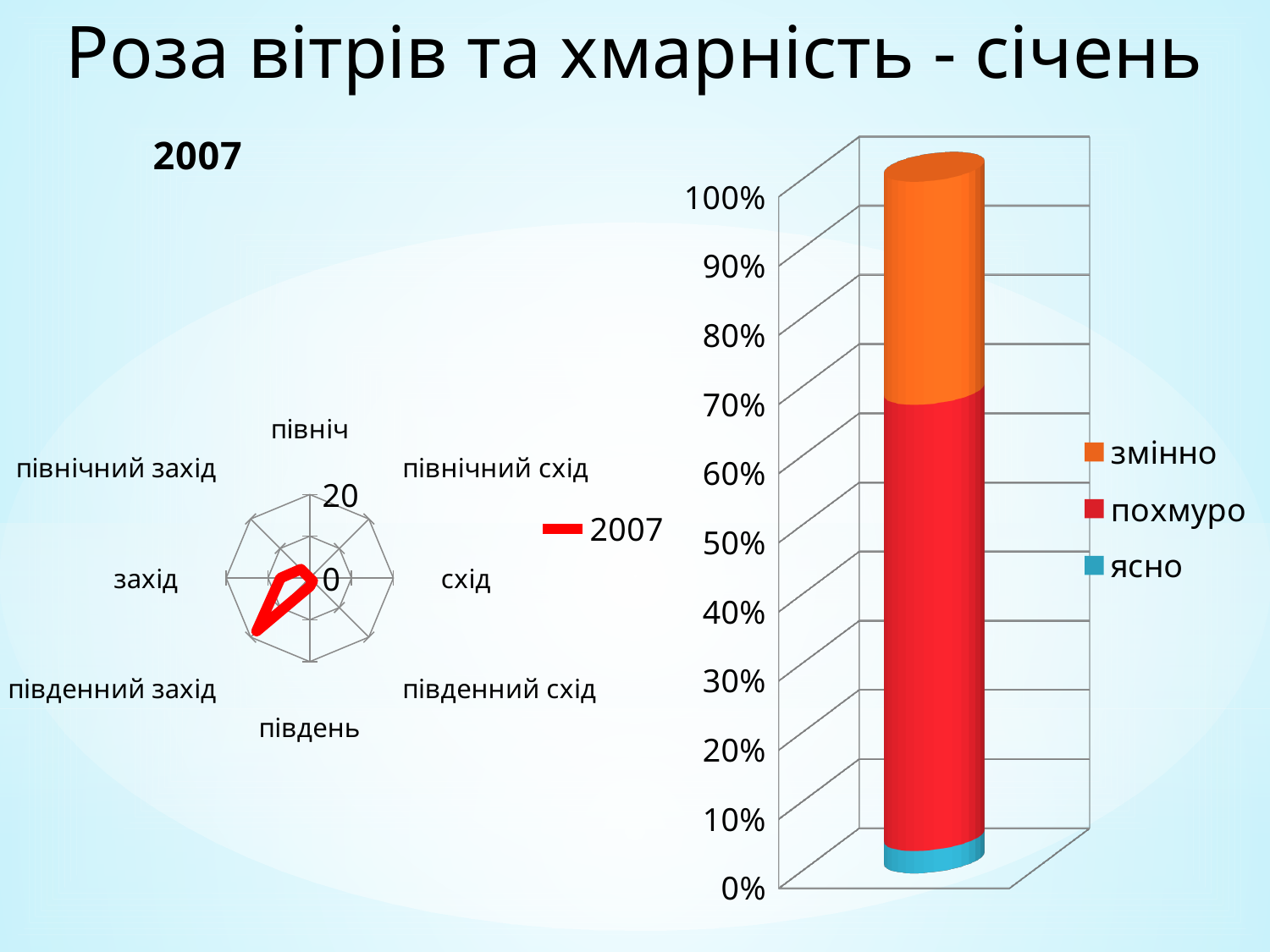
In the chart on the right, which is larger: the share for "похмуро" or the share for "змінно"? похмуро In the chart on the right, which series occupies the largest portion of the bar? похмуро In the chart on the right, how many series does the legend list? 3 In the chart on the right, is the share for "ясно" greater or less than 10%? less In the chart on the right, what are the three legend entries? змінно, похмуро, ясно In the left chart titled "2007", which wind direction has the highest value? південний захід In the left chart titled "2007", what is the highest tick value shown on the radial axis? 20 What kind of chart is the left chart titled "2007"? radar chart In the left chart titled "2007", how many wind directions (categories) are plotted? 8 In the chart on the right, which series occupies the smallest portion of the bar? ясно What kind of chart is the chart on the right of the slide? stacked bar chart In the left chart titled "2007", how many series does the legend list? 1